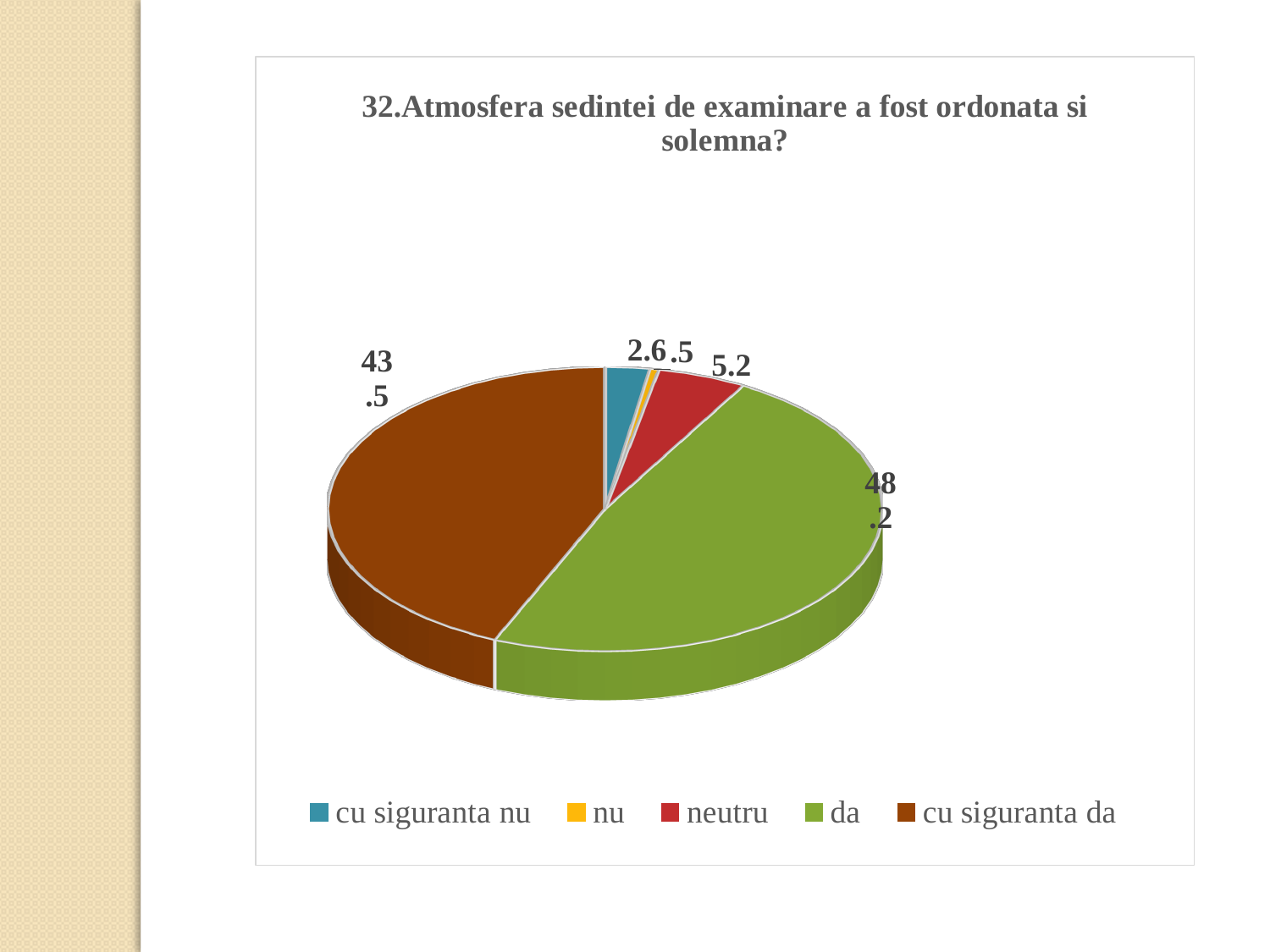
What is the title of the chart? 32.Atmosfera sedintei de examinare a fost ordonata si solemna? Which category has the largest slice of the pie? da What colour is the "da" slice in the pie chart? green What is the difference between the values for "da" and "cu siguranta da"? 4.7 How many categories are shown in the pie chart? 5 What is the value shown for the "da" slice? 48.2 Which is larger, the value for "neutru" or the value for "cu siguranta nu"? neutru What is the value shown for the "cu siguranta nu" slice? 2.6 What is the value shown for the "cu siguranta da" slice? 43.5 What kind of chart is shown on the slide? pie chart What is the value shown for the "neutru" slice? 5.2 Which category has the smallest slice of the pie? nu